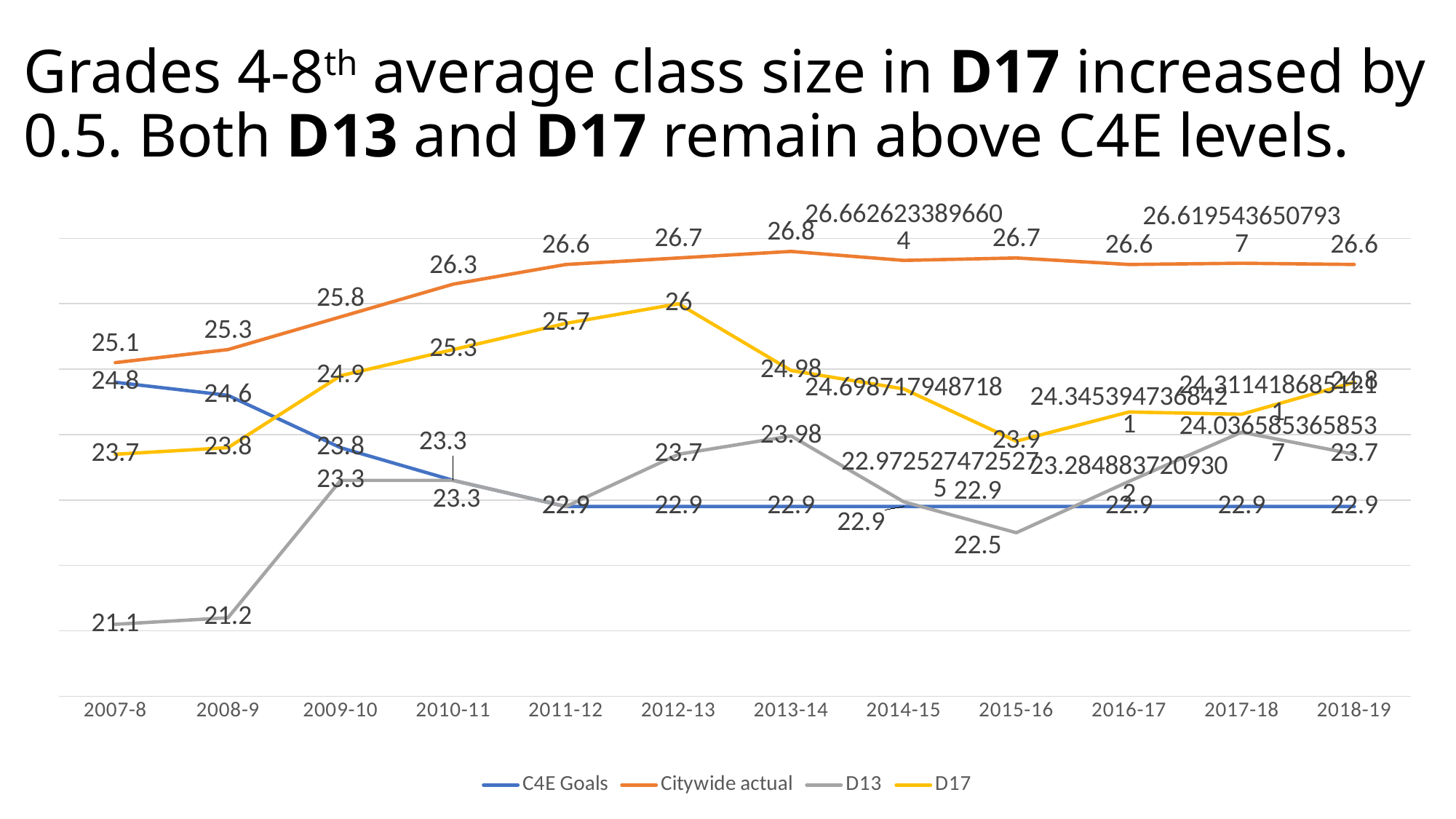
What is the difference between the Citywide actual value and the C4E Goals value in 2018-19? 3.7 What is the Citywide actual value for 2007-8? 25.1 What is the D13 value for 2007-8? 21.1 How many series does the legend list? 4 What is the D17 value for 2012-13? 26 Does the Citywide actual series rise or fall from 2007-8 to 2012-13? Rise What type of chart is shown on the slide? Line chart How many school years are plotted along the x axis? 12 In which school year is the D13 value lowest? 2007-8 In which school year is the Citywide actual value highest? 2013-14 Which is larger in 2012-13, the D17 value or the D13 value? D17 What is the D13 value for 2015-16? 22.5